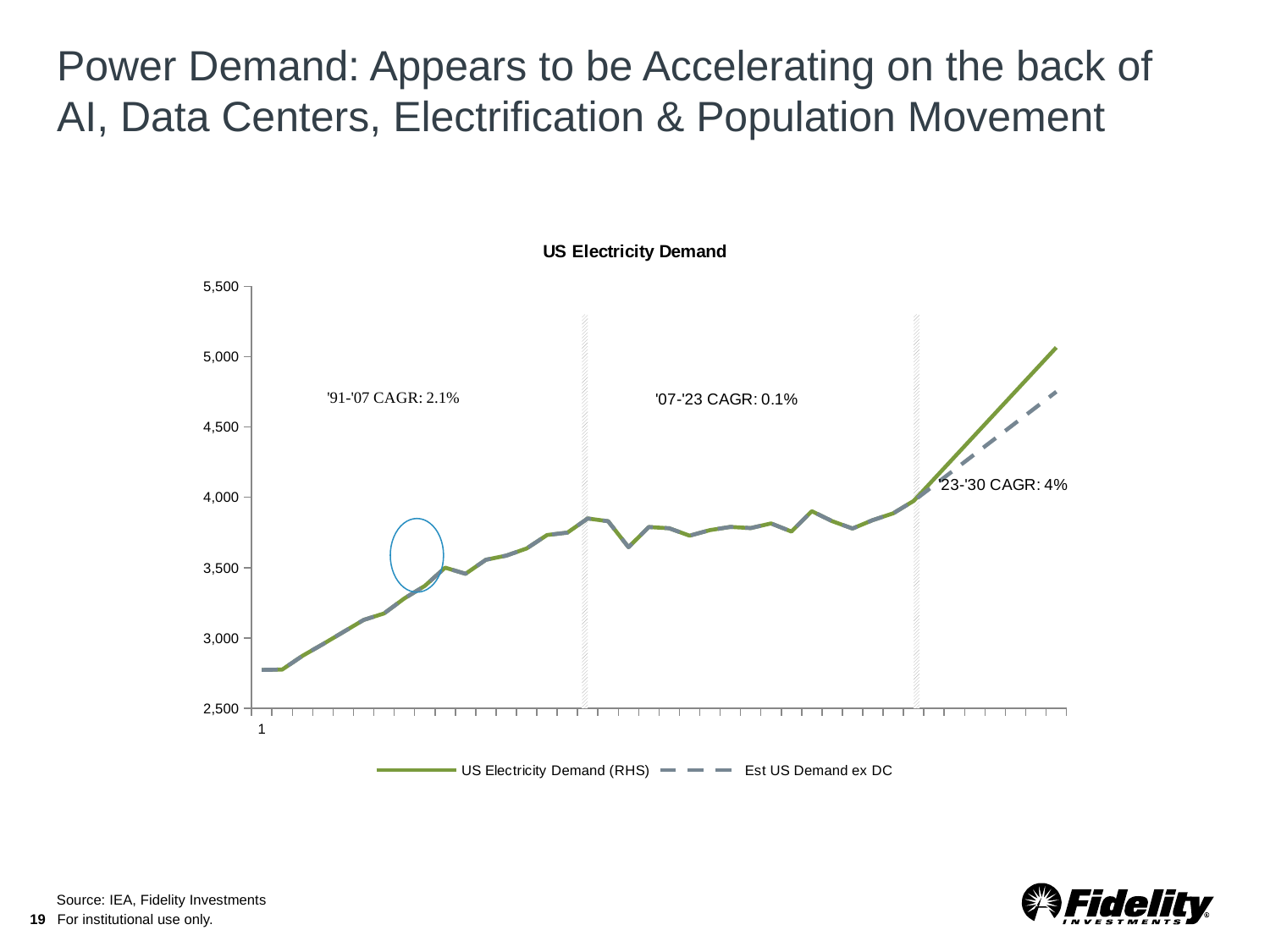
How many series does the chart legend list? 2 What CAGR does the chart show for the '91-'07 period? 2.1% Is the final value of the US Electricity Demand (RHS) line greater or less than 4,500? greater At the right end of the chart, which series is higher: US Electricity Demand (RHS) or Est US Demand ex DC? US Electricity Demand (RHS) What is the title of the chart? US Electricity Demand Which of the three periods annotated on the chart has the highest CAGR? '23-'30 What kind of chart is shown on the slide? Line chart What are the two series named in the chart legend? US Electricity Demand (RHS) and Est US Demand ex DC Does US Electricity Demand rise or fall overall from the left of the chart to the right? Rise Is the final value of the Est US Demand ex DC line greater or less than 5,000? less Is the starting value of the US Electricity Demand line at the left of the chart greater or less than 3,000? less What CAGR does the chart show for the '07-'23 period? 0.1%